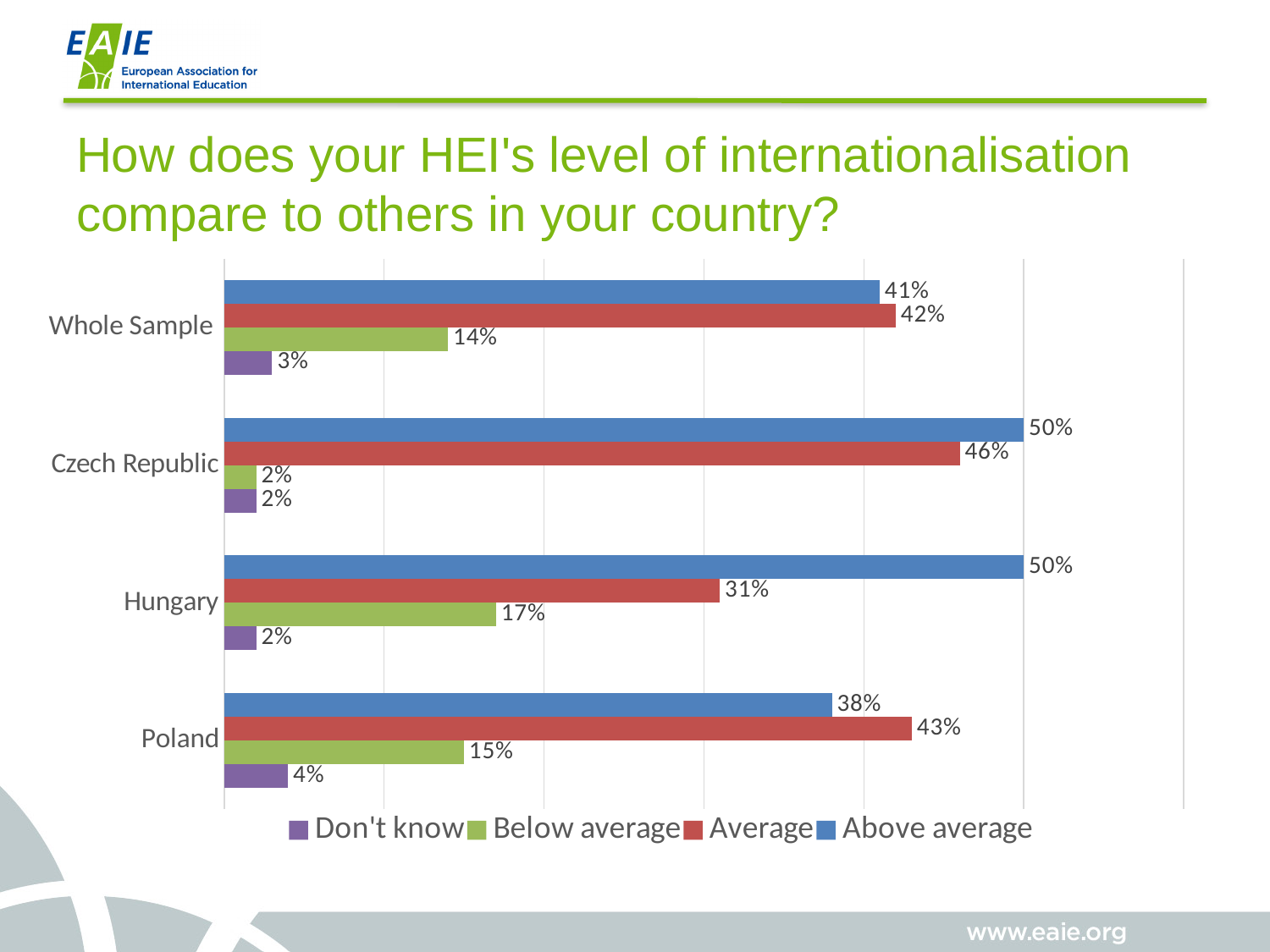
What is the 'Average' value for the Czech Republic? 46% What is the 'Above average' value for Hungary? 50% Which category has the highest 'Below average' value? Hungary Which category has the lowest 'Average' value? Hungary What is the 'Below average' value for the Whole Sample? 14% How many series does the legend list? 4 How many categories are shown on the chart? 4 What kind of chart is shown on the slide? Bar chart Which colour represents the 'Don't know' series in the legend? Purple What is the 'Don't know' value for Poland? 4% Is the 'Average' value for Poland larger than the 'Above average' value for Poland? Yes What is the difference between the 'Above average' and 'Average' values for Hungary? 19%